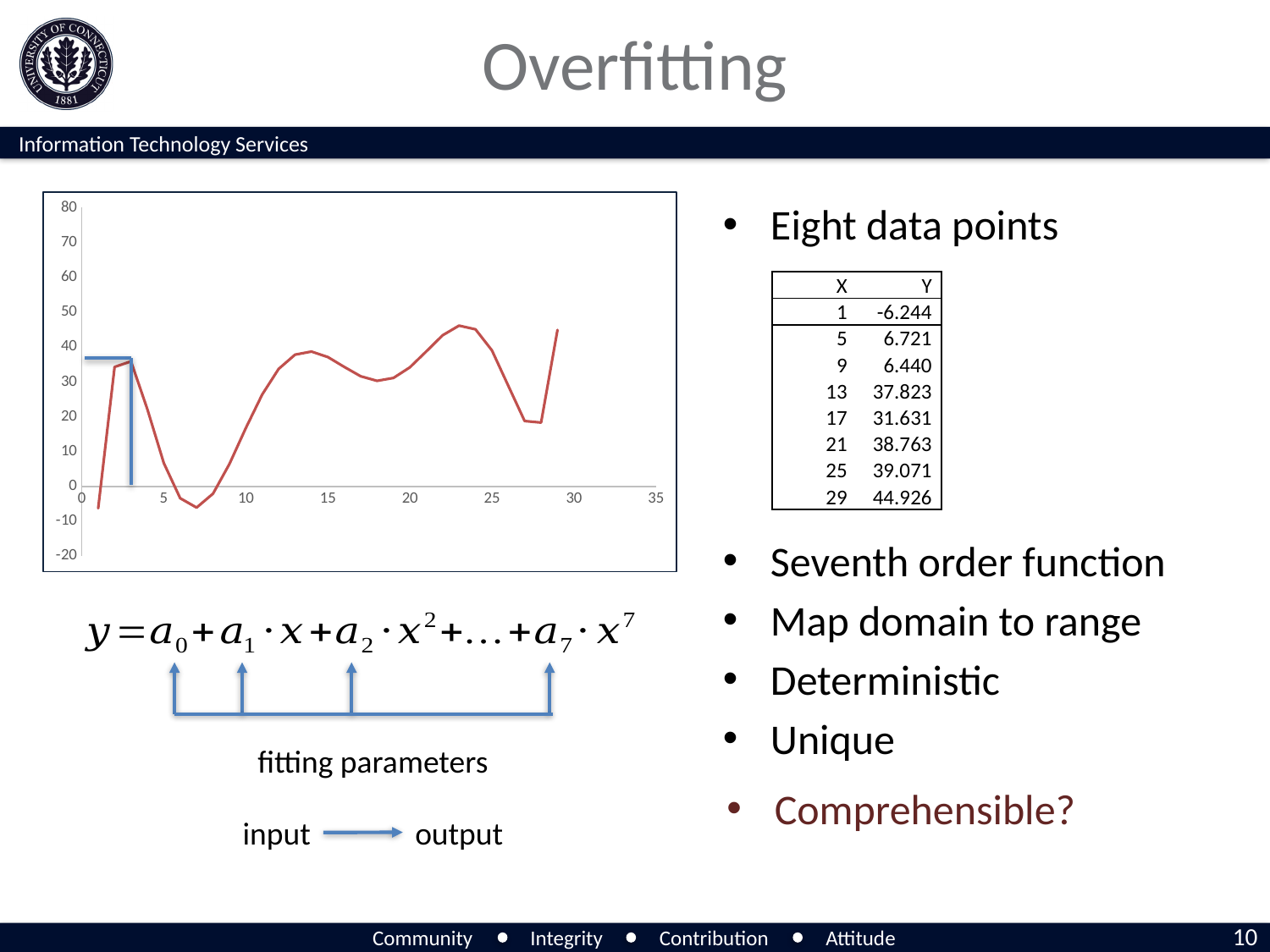
What is the highest value shown on the chart's vertical axis? 80 Is the value of the red curve at x = 7 greater or less than 0? less What is the largest tick value shown on the chart's horizontal axis? 35 According to the data table on the slide, how many data points are listed? 8 According to the data table on the slide, what is the Y value for X = 13? 37.823 Does the red curve rise or fall between x = 23 and x = 27? fall Is the value of the red curve at x = 14 greater or less than 30? greater Does the red curve rise or fall between x = 7 and x = 14? rise What kind of chart is shown on the left of the slide? line chart Is the value of the red curve at x = 23 greater or less than 40? greater